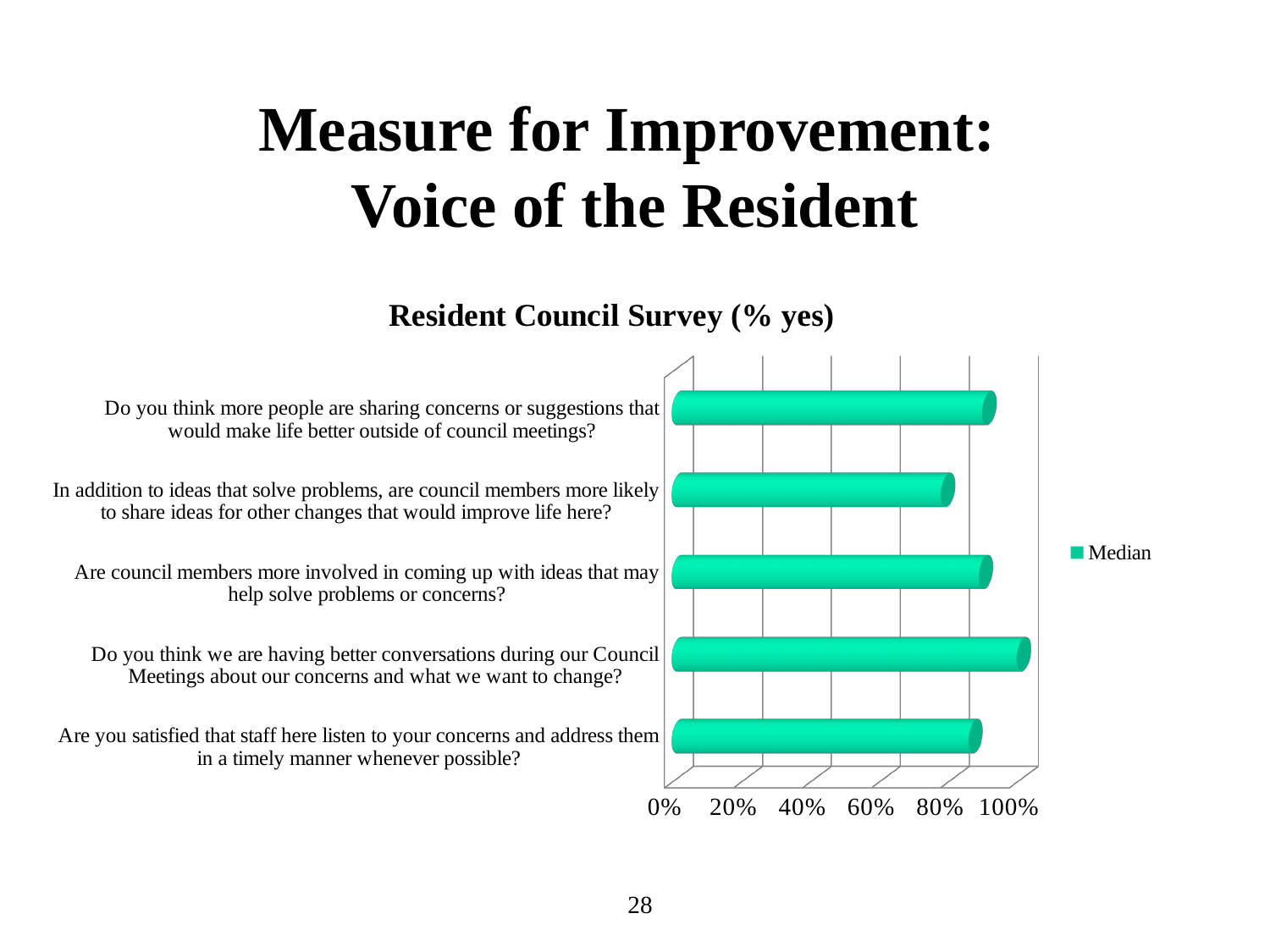
Which is larger: the value for "Do you think we are having better conversations during our Council Meetings about our concerns and what we want to change?" or the value for "In addition to ideas that solve problems, are council members more likely to share ideas for other changes that would improve life here?"? Do you think we are having better conversations during our Council Meetings about our concerns and what we want to change? Is the value for "In addition to ideas that solve problems, are council members more likely to share ideas for other changes that would improve life here?" greater or less than 100%? less Which survey question has the lowest value? In addition to ideas that solve problems, are council members more likely to share ideas for other changes that would improve life here? How many series does the legend list? 1 Is the value for "In addition to ideas that solve problems, are council members more likely to share ideas for other changes that would improve life here?" greater or less than 60%? greater What kind of chart is shown on the slide? bar chart Which survey question has the highest value? Do you think we are having better conversations during our Council Meetings about our concerns and what we want to change? How many survey questions (categories) are plotted in the chart? 5 What is the title of the chart? Resident Council Survey (% yes) Is the value for "Do you think we are having better conversations during our Council Meetings about our concerns and what we want to change?" greater or less than 80%? greater What is the name of the series shown in the legend? Median